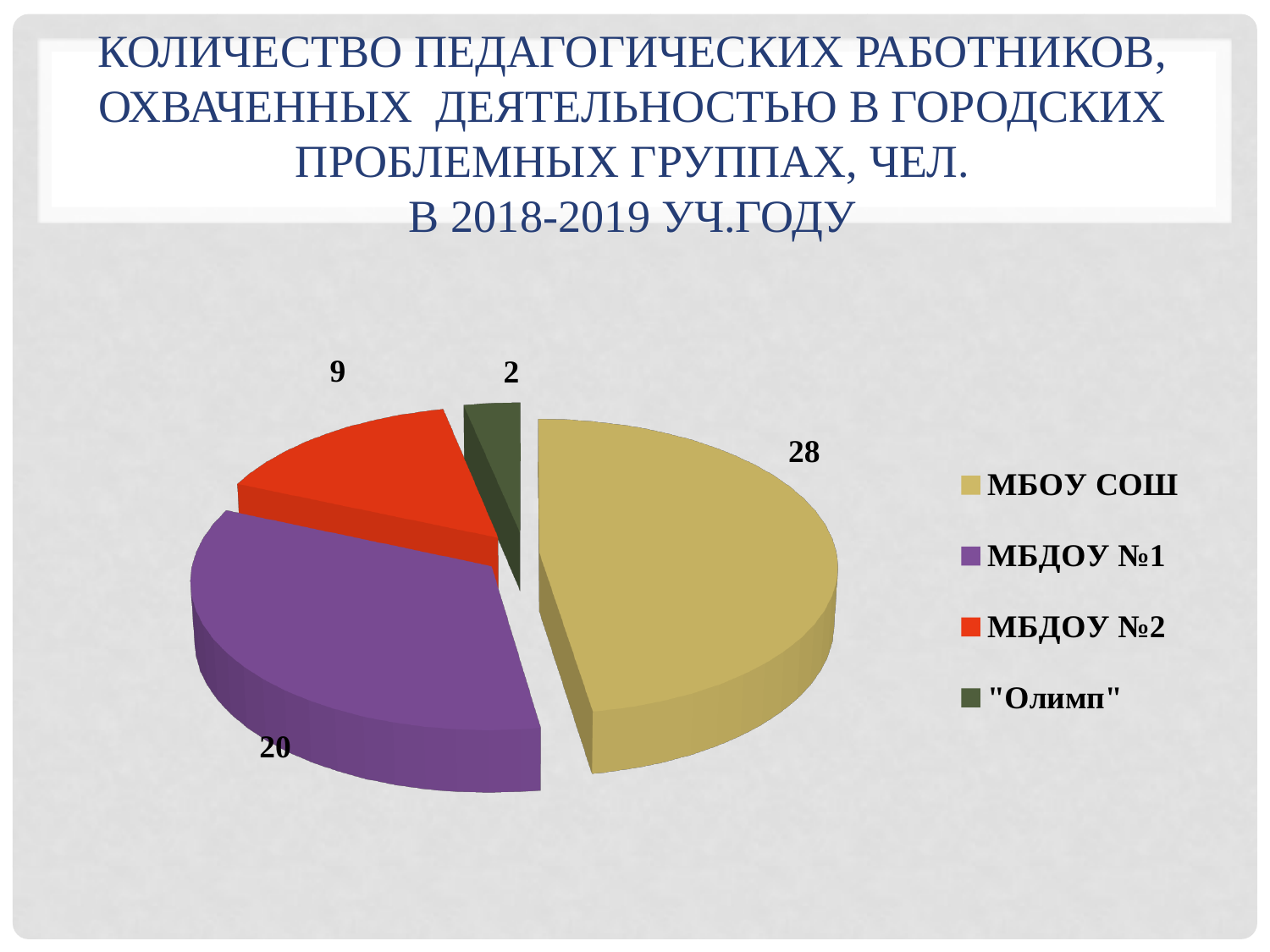
What is the value for МБОУ СОШ? 28 How many slices does the pie chart have? 4 How many entries does the legend list? 4 Which category has the smallest slice? "Олимп" What is the value for МБДОУ №2? 9 What is the value for "Олимп"? 2 Which is larger, the value for МБДОУ №2 or the value for "Олимп"? МБДОУ №2 What is the value for МБДОУ №1? 20 Which category has the largest slice? МБОУ СОШ What is the difference between the values for МБОУ СОШ and МБДОУ №1? 8 What is the total of all four slices? 59 What kind of chart is shown on the slide? pie chart